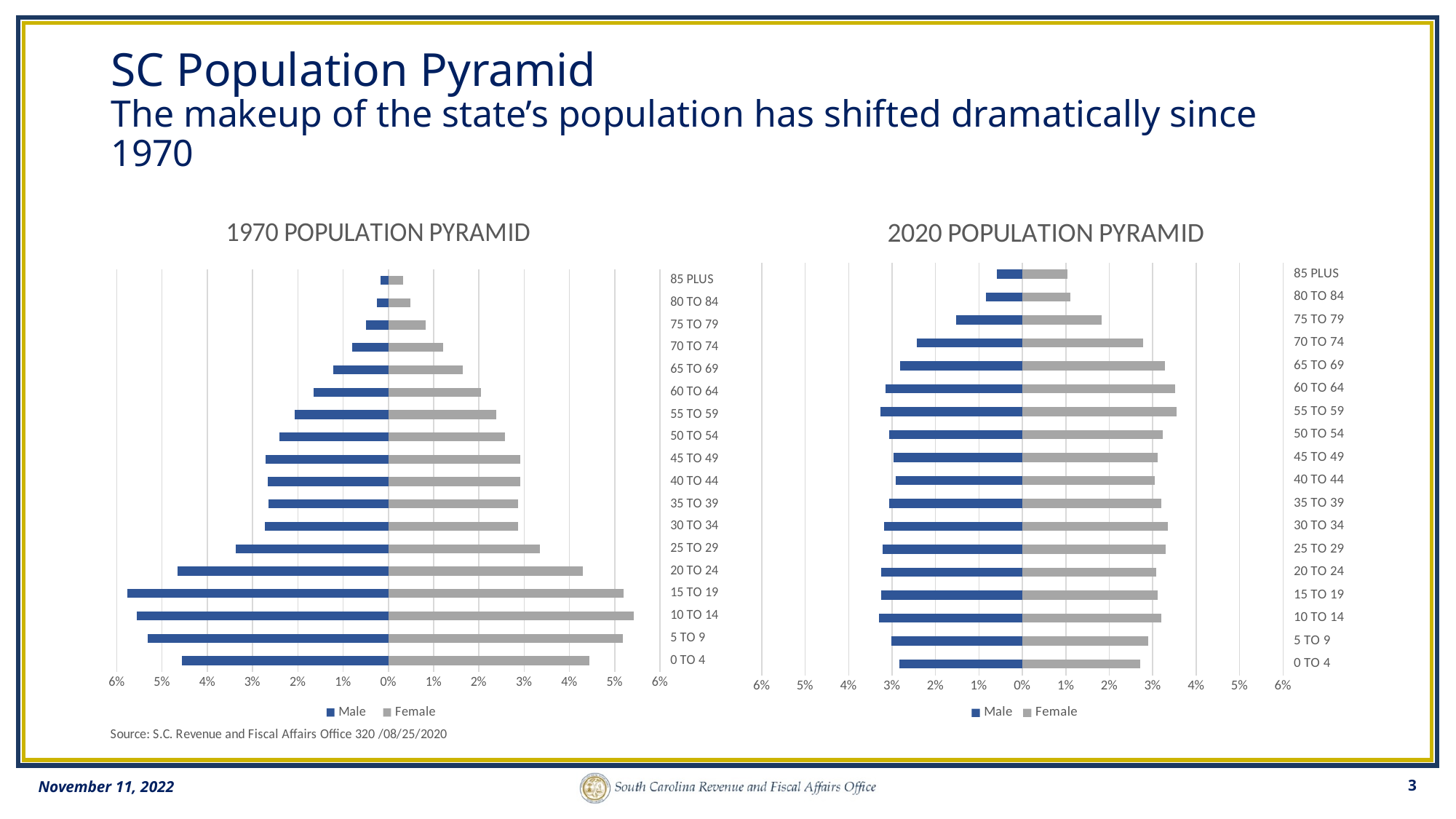
In the 1970 Population Pyramid, is the Male value for 15 TO 19 greater or less than 5%? greater Which colour represents Female in the 2020 Population Pyramid? gray What kind of chart is the 1970 Population Pyramid? bar chart In the 2020 Population Pyramid, which age group has the smallest Male value? 85 PLUS In the 2020 Population Pyramid, is the Male value for 0 TO 4 greater or less than 3%? less In the 1970 Population Pyramid, which age group has the smallest Male value? 85 PLUS How many age categories are shown in the 1970 Population Pyramid? 18 In the 1970 Population Pyramid, which is larger, the Male value for 20 TO 24 or for 25 TO 29? 20 TO 24 In the 1970 Population Pyramid, is the Female value for 0 TO 4 greater or less than 4%? greater In the 1970 Population Pyramid, which age group has the largest Male value? 15 TO 19 How many series does the legend of the 2020 Population Pyramid list? 2